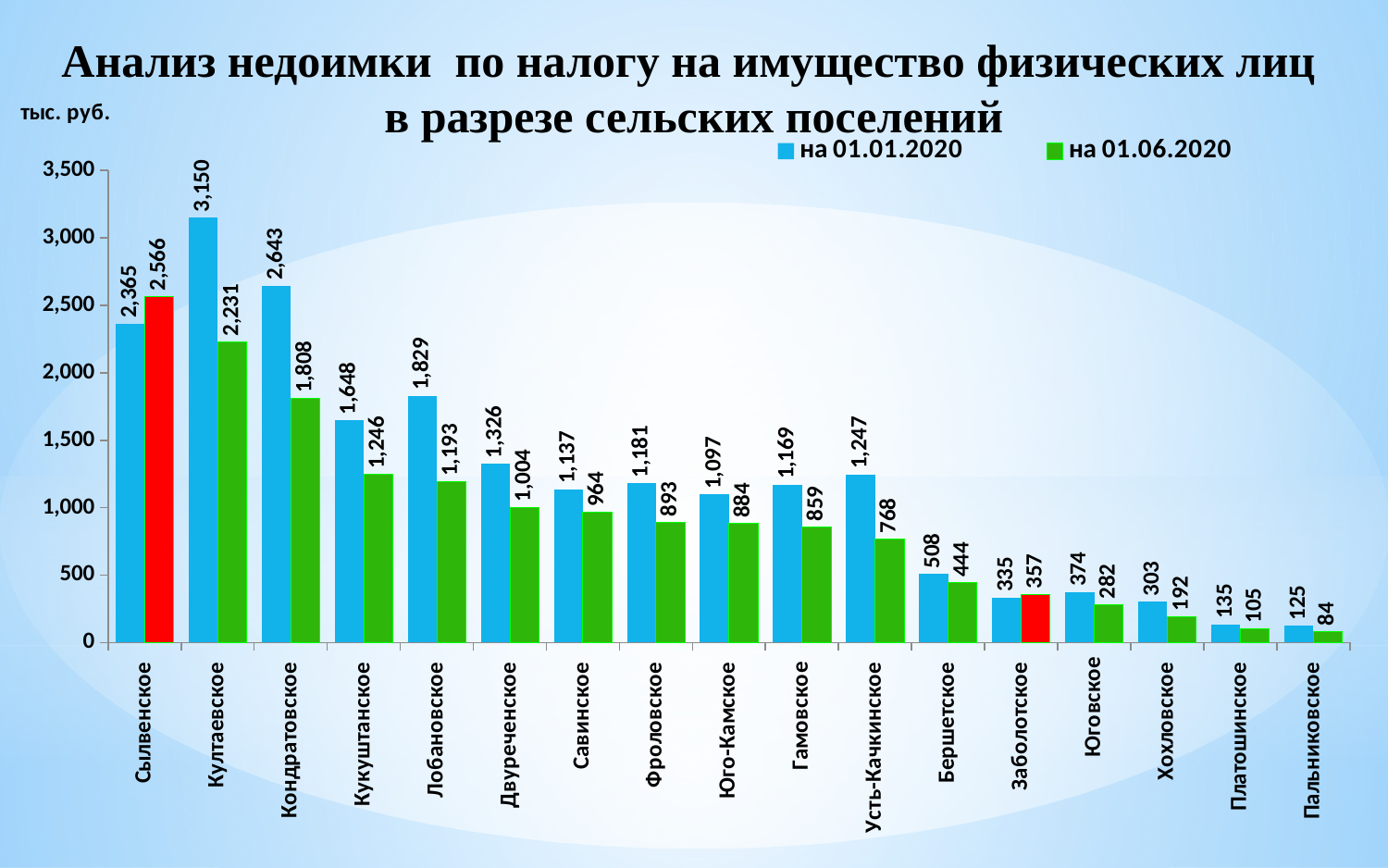
What is the value for Заболотское in the series на 01.06.2020? 357 What unit is indicated at the top of the vertical axis? тыс. руб. For Сылвенское, which is larger: the value на 01.01.2020 or the value на 01.06.2020? на 01.06.2020 How many settlements are shown on the x axis? 17 What is the value for Култаевское in the series на 01.01.2020? 3,150 How many series does the legend list? 2 What is the value for Сылвенское in the series на 01.06.2020? 2,566 Is the value for Лобановское in the series на 01.01.2020 greater or less than 1,500? greater Which settlement has the lowest value in the series на 01.06.2020? Пальниковское Which settlement has the highest value in the series на 01.01.2020? Култаевское What kind of chart is shown on the slide? Bar chart What is the difference between the на 01.01.2020 and на 01.06.2020 values for Кондратовское? 835